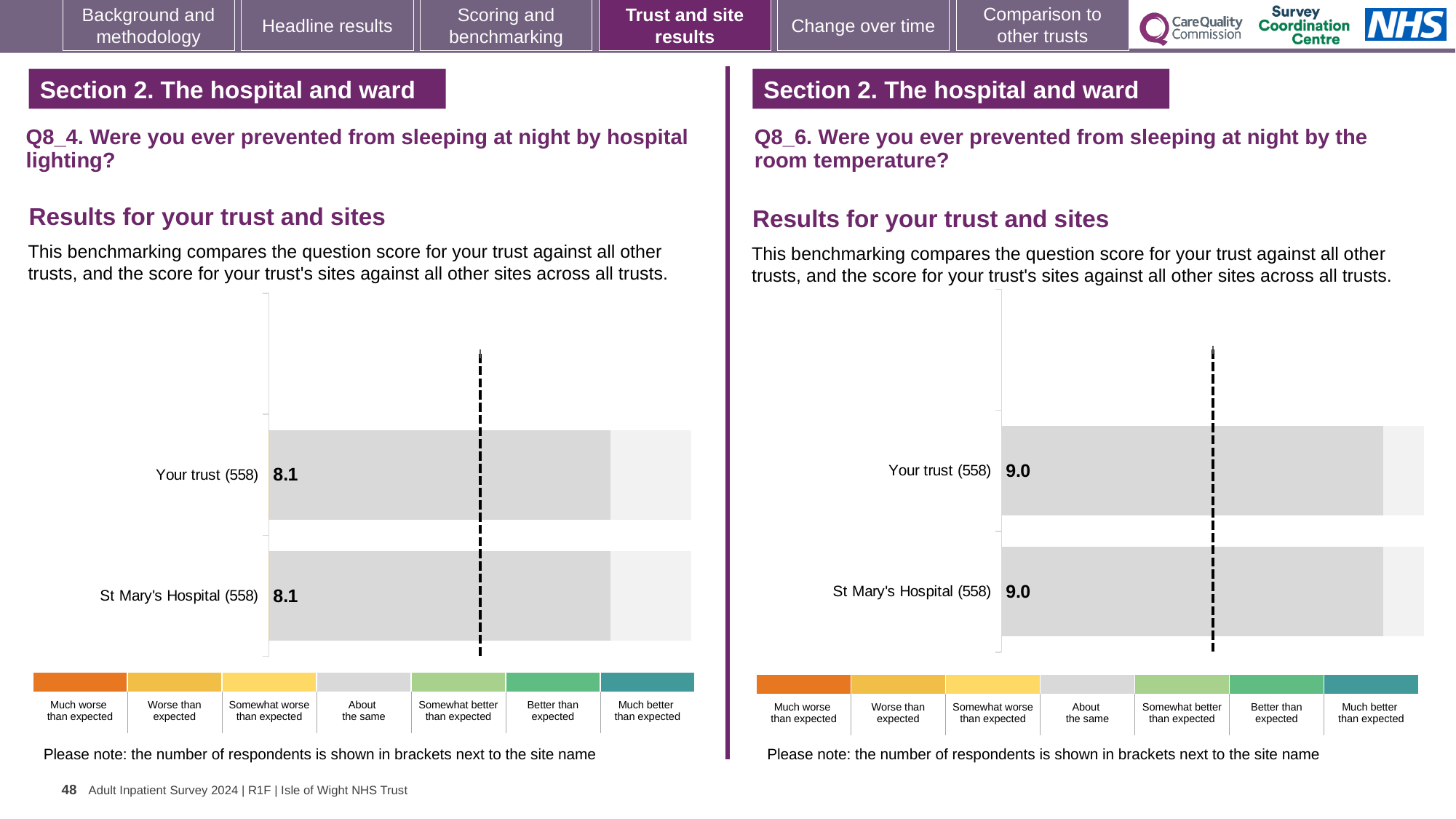
In the Q8_4 chart (hospital lighting), what is the difference between the score for Your trust and the score for St Mary's Hospital? 0.0 In the Q8_4 chart (hospital lighting), what is the score for St Mary's Hospital (558)? 8.1 How many categories does the colour key below the Q8_6 chart (room temperature) list? 7 In the Q8_4 chart (hospital lighting), how many respondents are shown in brackets next to St Mary's Hospital? 558 In the Q8_6 chart (room temperature), what is the difference between the score for Your trust and the score for St Mary's Hospital? 0.0 What kind of chart is used for the Q8_6 results (room temperature)? Bar chart In the Q8_6 chart (room temperature), what is the score for Your trust (558)? 9.0 In the Q8_6 chart (room temperature), what is the score for St Mary's Hospital (558)? 9.0 How many bars are plotted in the Q8_4 chart (hospital lighting)? 2 How many bars are plotted in the Q8_6 chart (room temperature)? 2 In the Q8_4 chart (hospital lighting), what is the score for Your trust (558)? 8.1